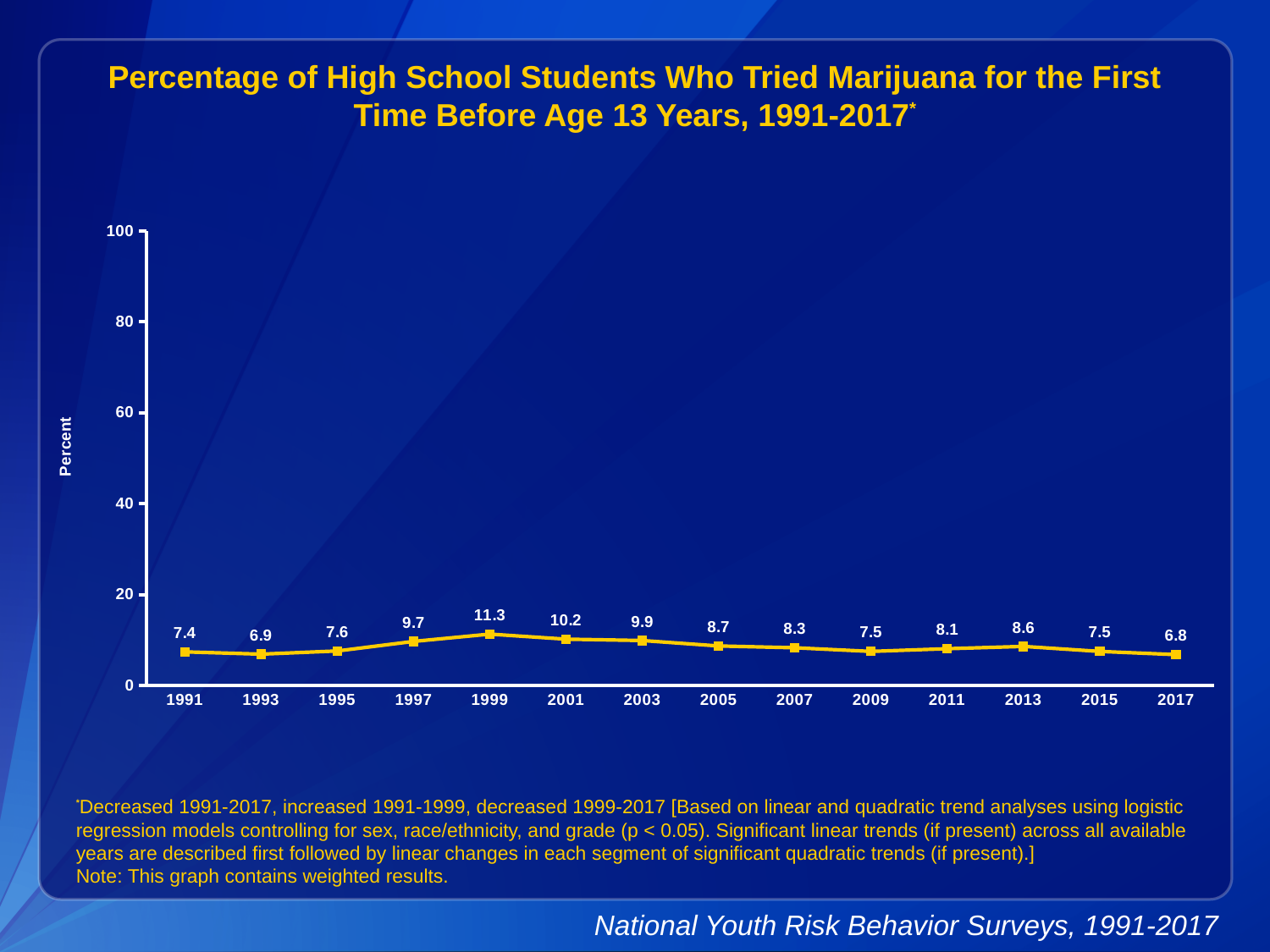
What is the difference between the values for 1999 and 2017? 4.5 What was the percentage of high school students who tried marijuana before age 13 in 1999? 11.3 Which year has the lowest value on the chart? 2017 Do the values rise or fall from 1999 to 2017? fall What value is shown for 1991? 7.4 What value is shown for 2017? 6.8 What kind of chart is shown on the slide? line chart What is the label on the y axis? Percent Which year has a larger value, 2013 or 2015? 2013 How many years are plotted on the chart? 14 Is the value for 2001 greater or less than 20? less Which year has the highest value on the chart? 1999